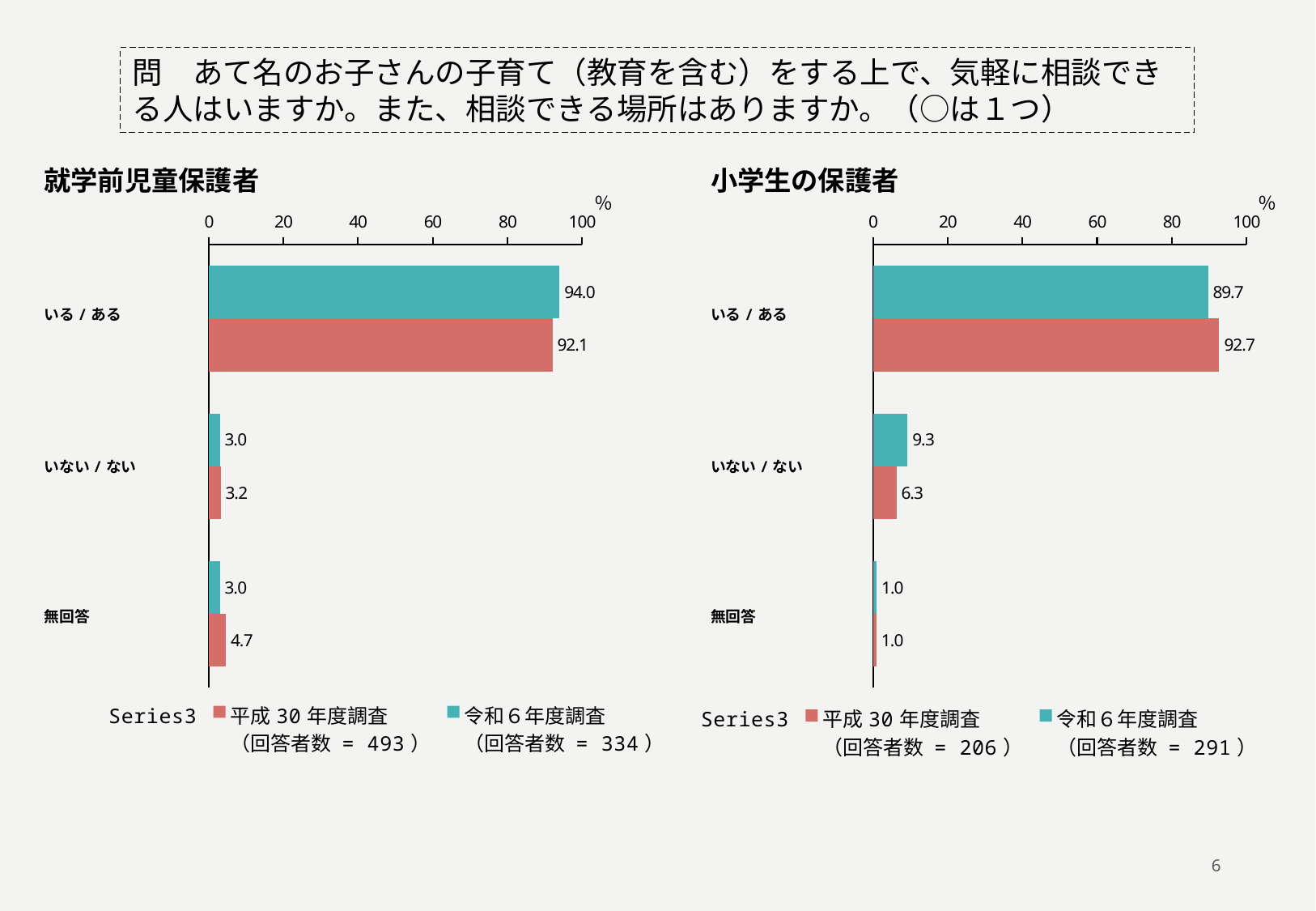
In the 小学生の保護者 chart, what is the value for いる / ある in the 平成30年度調査 series? 92.7 In the 小学生の保護者 chart, what is the difference between the 平成30年度調査 and 令和６年度調査 values for いる / ある? 3.0 What kind of chart is the 就学前児童保護者 chart? bar chart In the 就学前児童保護者 chart, what is the difference between the 平成30年度調査 and 令和６年度調査 values for 無回答? 1.7 In the 小学生の保護者 chart, which series has the larger value for いない / ない, 平成30年度調査 or 令和６年度調査? 令和６年度調査 How many categories are shown in the 小学生の保護者 chart? 3 In the 小学生の保護者 chart, what is the value for いない / ない in the 令和６年度調査 series? 9.3 In the 就学前児童保護者 chart, is the 令和６年度調査 value for いる / ある greater or less than 80? greater In the 小学生の保護者 chart, which category has the highest value in the 令和６年度調査 series? いる / ある In the 就学前児童保護者 chart, what is the value for いる / ある in the 令和６年度調査 series? 94.0 In the 就学前児童保護者 chart, which category has the lowest value in the 平成30年度調査 series? いない / ない In the 就学前児童保護者 chart, what is the value for 無回答 in the 平成30年度調査 series? 4.7